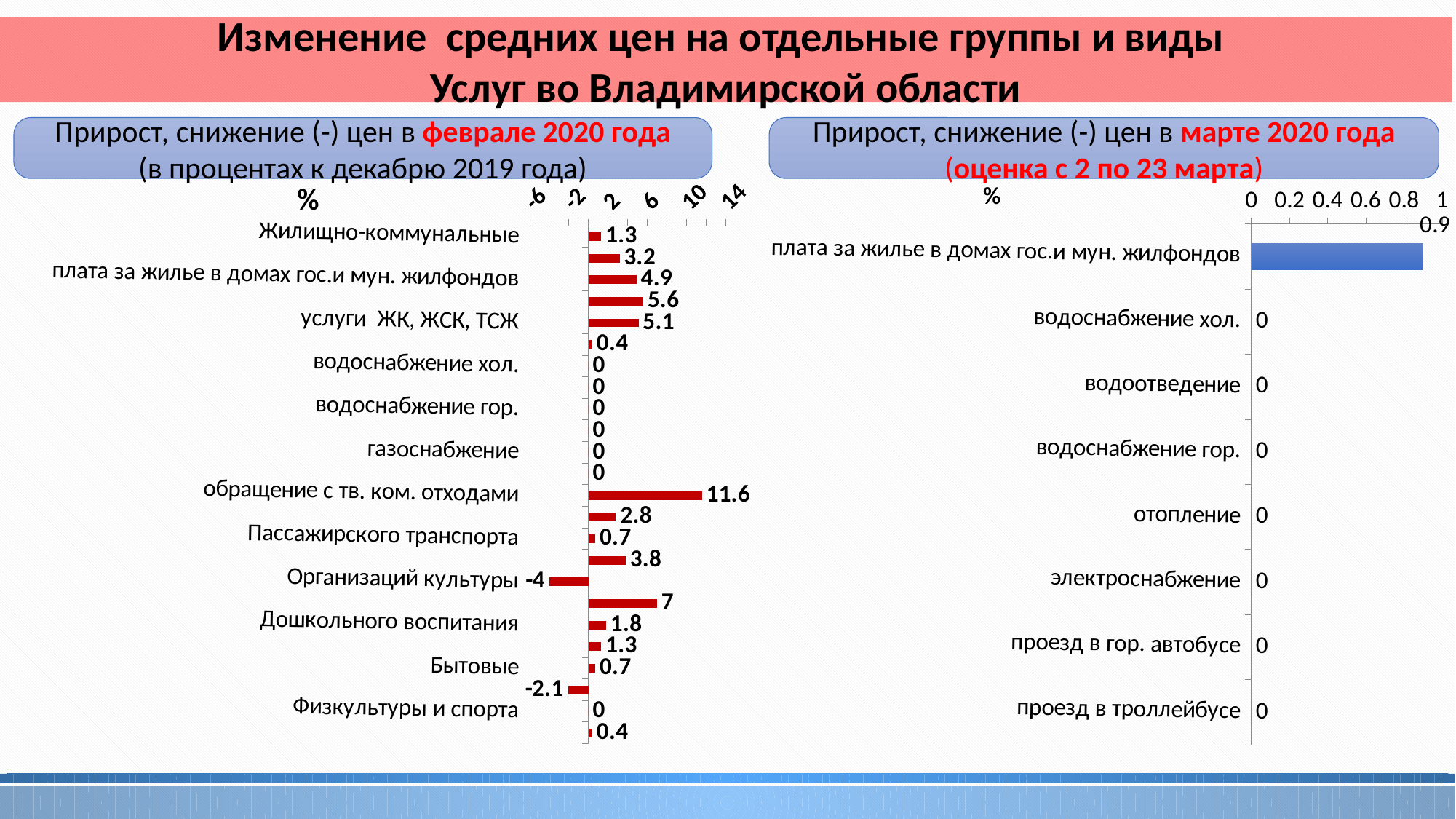
In the right chart (March 2020), which category has the highest value? плата за жилье в домах гос.и мун. жилфондов In the right chart (March 2020), what is the value for плата за жилье в домах гос.и мун. жилфондов? 0.9 In the right chart (March 2020), is the value for плата за жилье в домах гос.и мун. жилфондов greater or less than 0.8? greater In the left chart (February 2020), what is the lowest value shown? -4 In the right chart (March 2020), how many categories are listed? 8 In the left chart (February 2020), what is the highest value shown? 11.6 In the left chart (February 2020), what is the value for Организаций культуры? -4 What kind of chart is the left chart (February 2020)? Bar chart What colour are the bars in the right chart (March 2020)? Blue In the right chart (March 2020), what is the value for водоотведение? 0 In the left chart (February 2020), what is the value for обращение с тв. ком. отходами? 11.6 In the left chart (February 2020), how many bars have negative values? 2